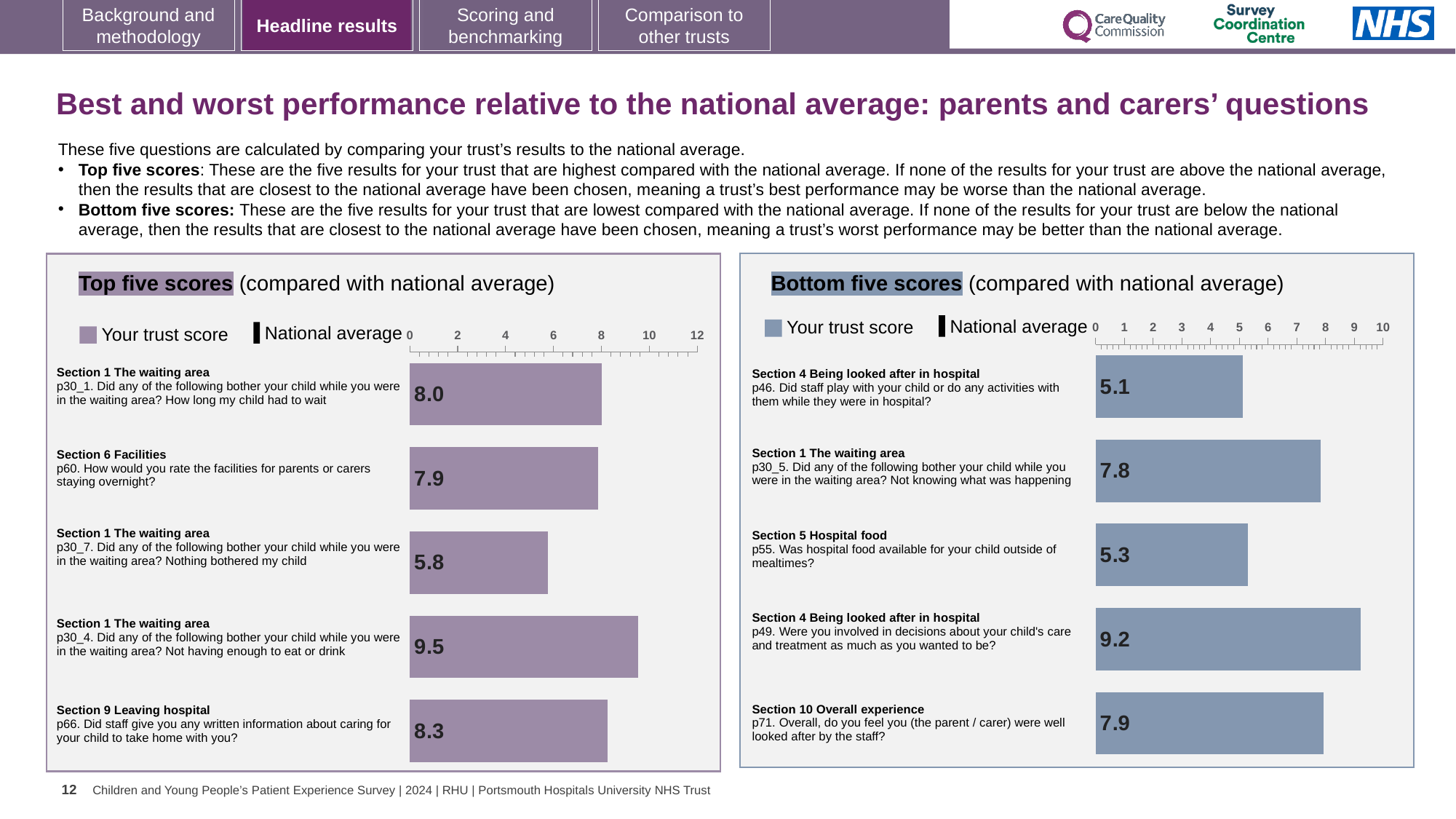
In the Top five scores chart, what is the difference between the trust scores for p30_4 and p30_7? 3.7 In the Top five scores chart, how many questions are plotted? 5 In the Bottom five scores chart, what is the difference between the trust scores for p49 and p46? 4.1 In the Bottom five scores chart, which is larger: the trust score for p30_5 or for p55? p30_5 How many entries does the legend of the Bottom five scores chart list? 2 In the Top five scores chart, what is the trust score for p60 (How would you rate the facilities for parents or carers staying overnight?)? 7.9 In the Bottom five scores chart, what is the trust score for p71 (Overall, do you feel you (the parent / carer) were well looked after by the staff?)? 7.9 In the Bottom five scores chart, what is the trust score for p46 (Did staff play with your child or do any activities with them while they were in hospital?)? 5.1 In the Top five scores chart, which question has the highest trust score? p30_4. Not having enough to eat or drink What type of chart is used in the Top five scores panel? Bar chart In the Bottom five scores chart, which question has the lowest trust score? p46. Did staff play with your child or do any activities with them while they were in hospital? In the Top five scores chart, what is the trust score for p30_7 (Nothing bothered my child)? 5.8